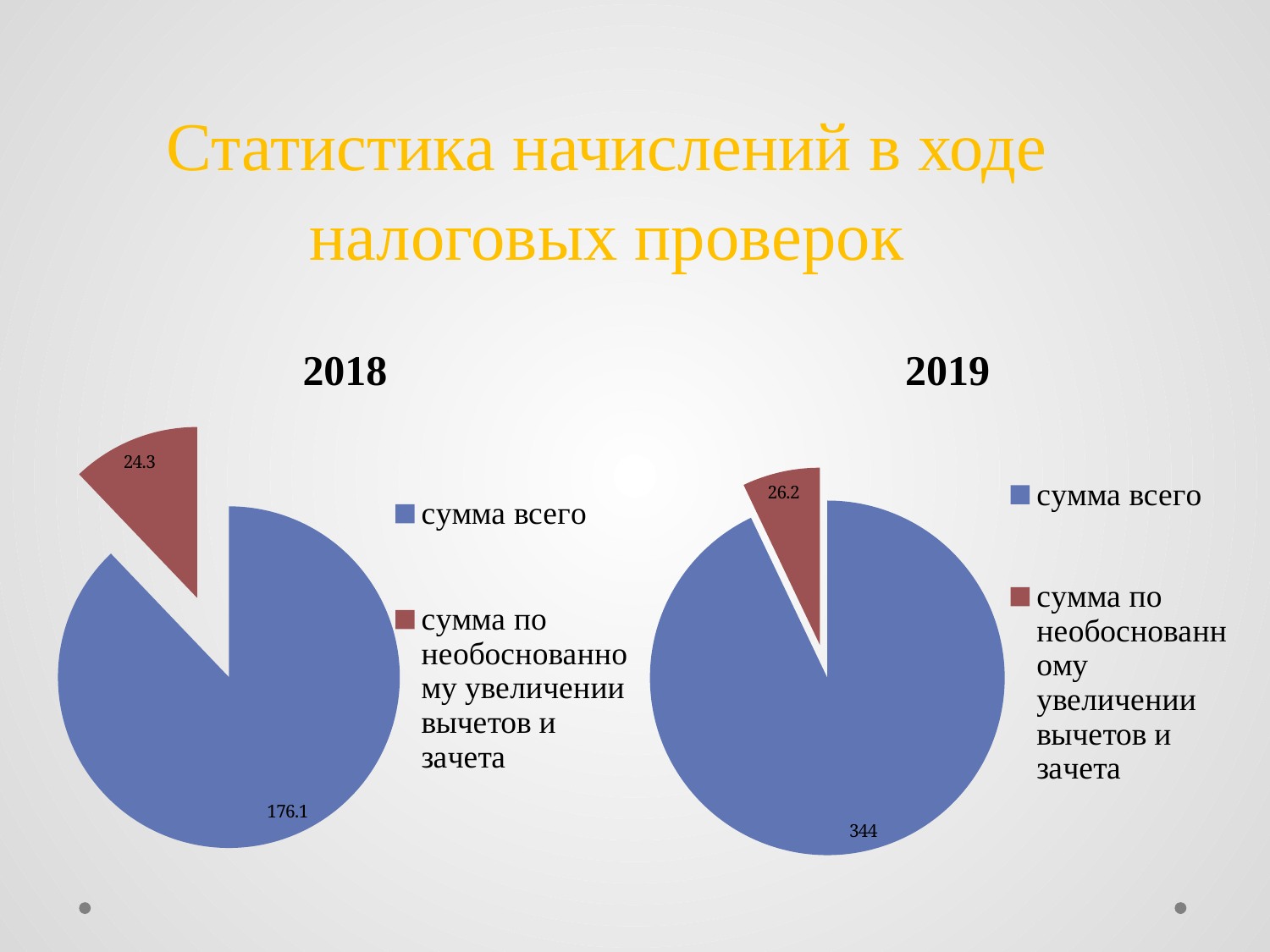
In the 2019 pie chart, what is the value for "сумма всего"? 344 In the 2018 pie chart, what is the value for "сумма по необоснованному увеличении вычетов и зачета"? 24.3 Which is larger: "сумма всего" in the 2018 chart or "сумма всего" in the 2019 chart? 2019 What is the total of the two slices in the 2019 pie chart? 370.2 In the 2019 pie chart, what is the value for "сумма по необоснованному увеличении вычетов и зачета"? 26.2 In the 2018 pie chart, what is the value for "сумма всего"? 176.1 In the 2018 pie chart, what is the difference between the two slice values? 151.8 How many entries does the legend of the 2019 chart list? 2 In the 2018 pie chart, which category has the smallest slice? сумма по необоснованному увеличении вычетов и зачета What is the difference between the "сумма всего" value in the 2019 chart and in the 2018 chart? 167.9 What type of chart is used for the 2018 data? Pie chart In the 2019 pie chart, which category has the largest slice? сумма всего